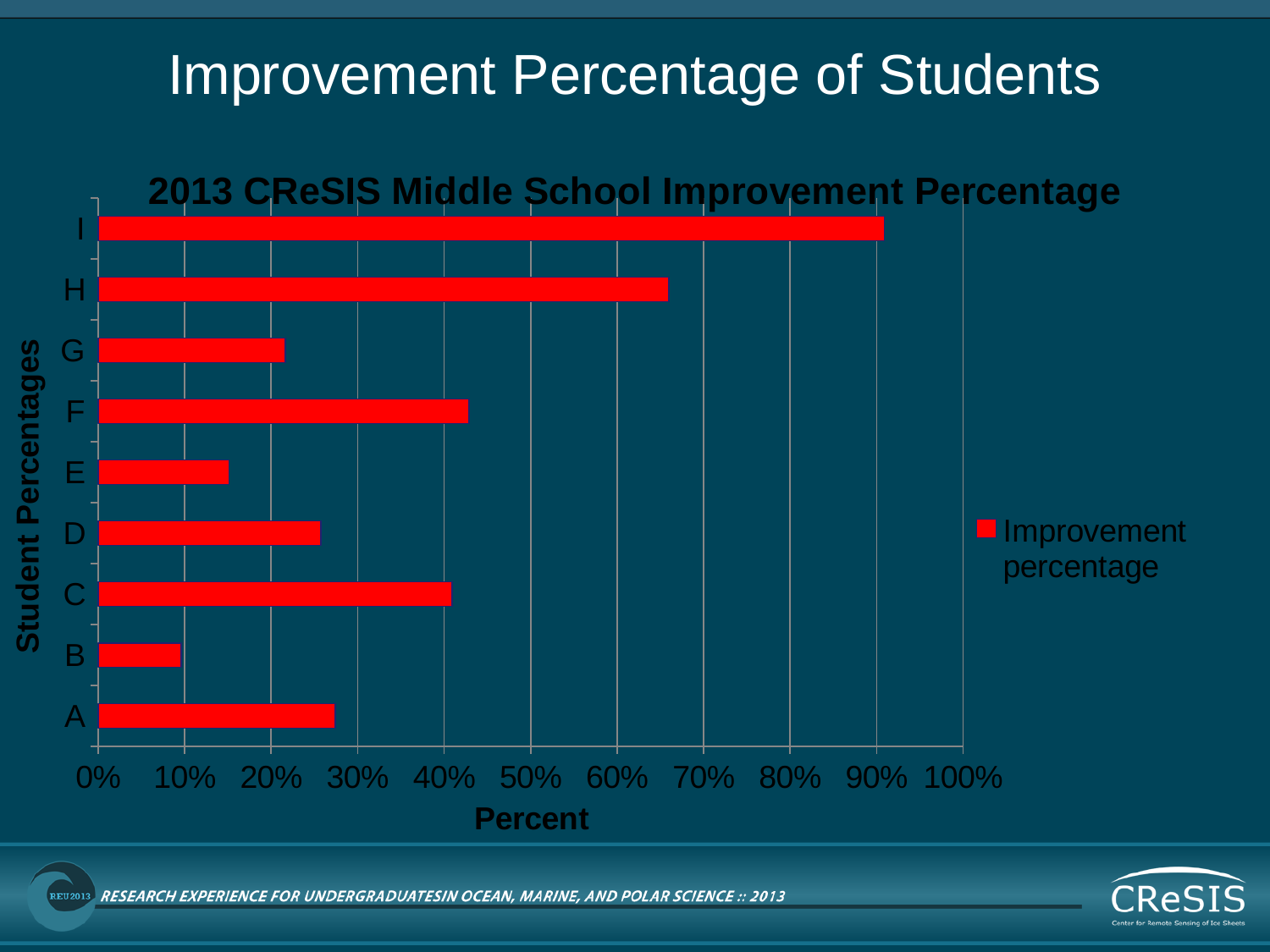
What is the title of the chart? 2013 CReSIS Middle School Improvement Percentage How many series does the legend list? 1 Which student has a higher improvement percentage, C or A? C What is the label on the horizontal axis of the chart? Percent How many student categories are plotted on the chart? 9 Is the improvement percentage for student E greater or less than 20%? less Which student has the highest improvement percentage? I Is the improvement percentage for student I greater or less than 80%? greater Which student has the lowest improvement percentage? B Is the improvement percentage for student H greater or less than 60%? greater What kind of chart is shown on the slide? bar chart Which student has a higher improvement percentage, H or F? H